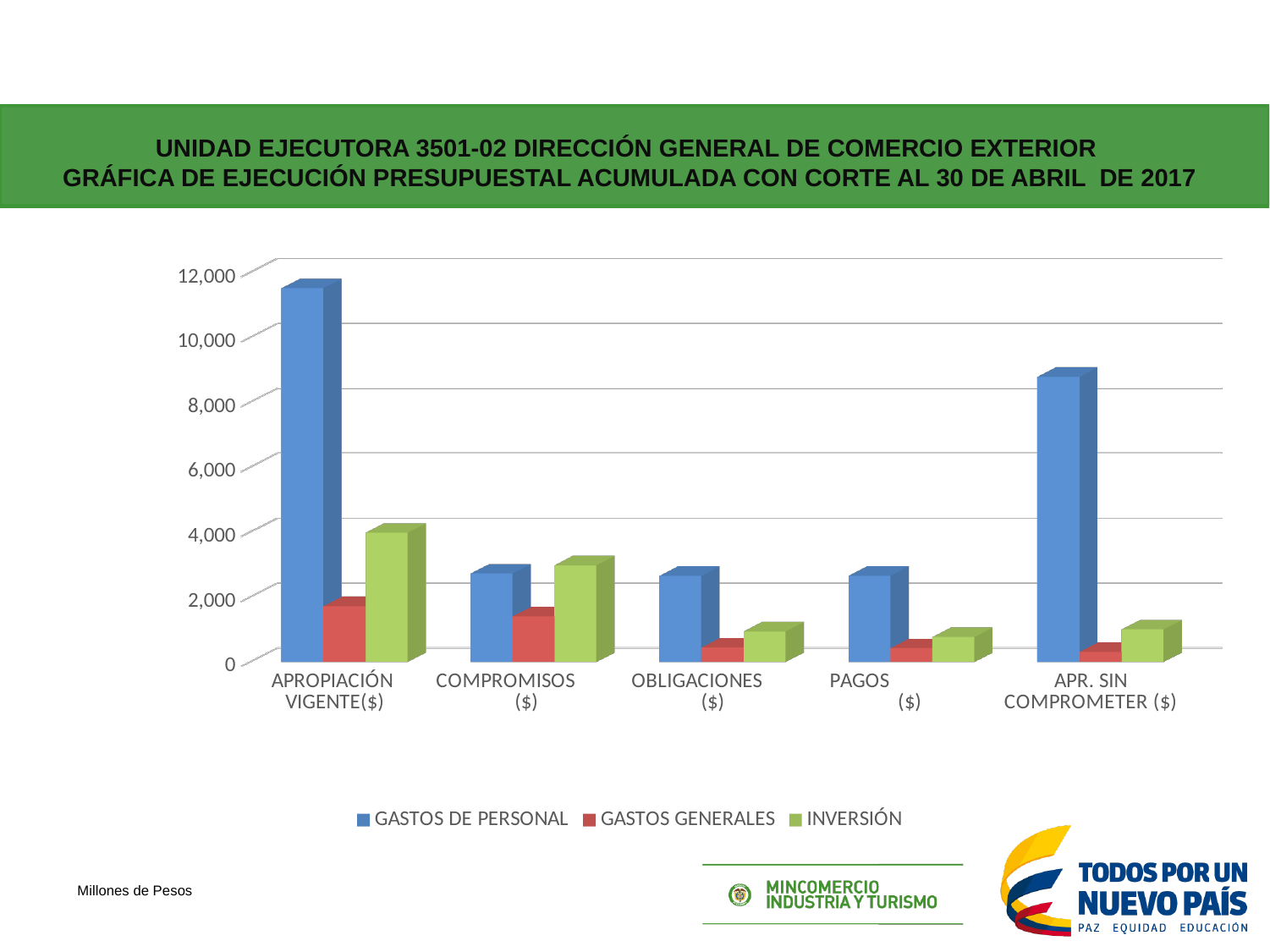
For the GASTOS GENERALES series, which category has the highest value? APROPIACIÓN VIGENTE($) Is the GASTOS GENERALES value for APROPIACIÓN VIGENTE($) greater or less than 2,000? less In the APROPIACIÓN VIGENTE($) category, which is larger: GASTOS DE PERSONAL or INVERSIÓN? GASTOS DE PERSONAL Which colour represents the INVERSIÓN series in the legend? green Is the GASTOS DE PERSONAL value for APR. SIN COMPROMETER ($) greater or less than 8,000? greater How many categories are shown along the x axis? 5 What kind of chart is shown on the slide? bar chart Is the GASTOS DE PERSONAL value for APROPIACIÓN VIGENTE($) greater or less than 10,000? greater For the INVERSIÓN series, which category has the highest value? APROPIACIÓN VIGENTE($) In the COMPROMISOS ($) category, which is larger: GASTOS GENERALES or INVERSIÓN? INVERSIÓN For the GASTOS DE PERSONAL series, which category has the highest value? APROPIACIÓN VIGENTE($) How many series does the legend list? 3